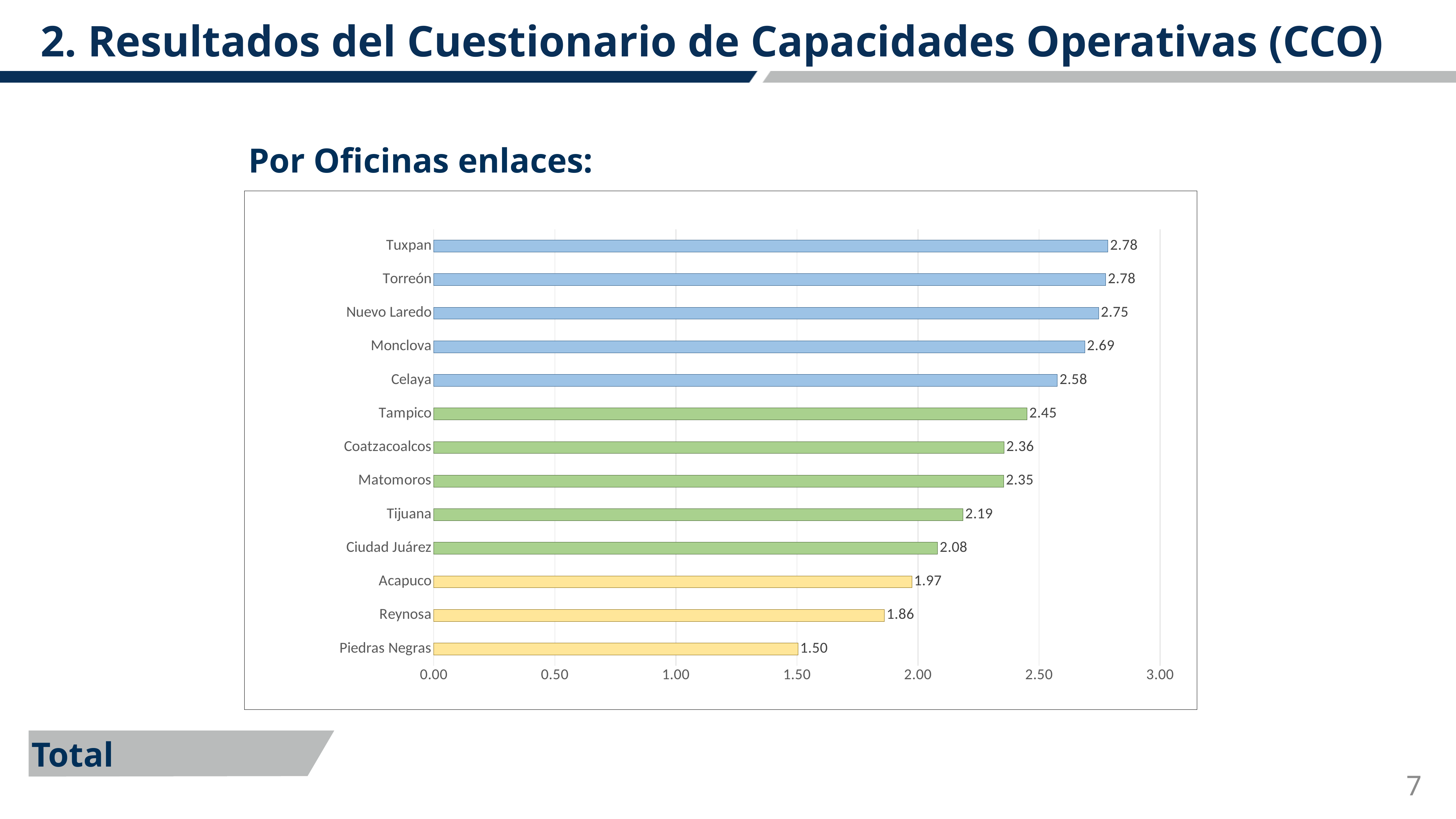
How many offices are shown in the chart? 13 What is the difference between the values for Tampico and Ciudad Juárez? 0.37 What is the value for Piedras Negras? 1.50 What is the value for Coatzacoalcos? 2.36 What colour are the bars for Acapuco, Reynosa and Piedras Negras? Yellow Is the value for Acapuco greater or less than 2.00? less What is the value for Tijuana? 2.19 What is the value for Monclova? 2.69 Which has a larger value, Celaya or Reynosa? Celaya Which office has the lowest value? Piedras Negras What kind of chart is shown on the slide? Bar chart What is the difference between the values for Tuxpan and Piedras Negras? 1.28